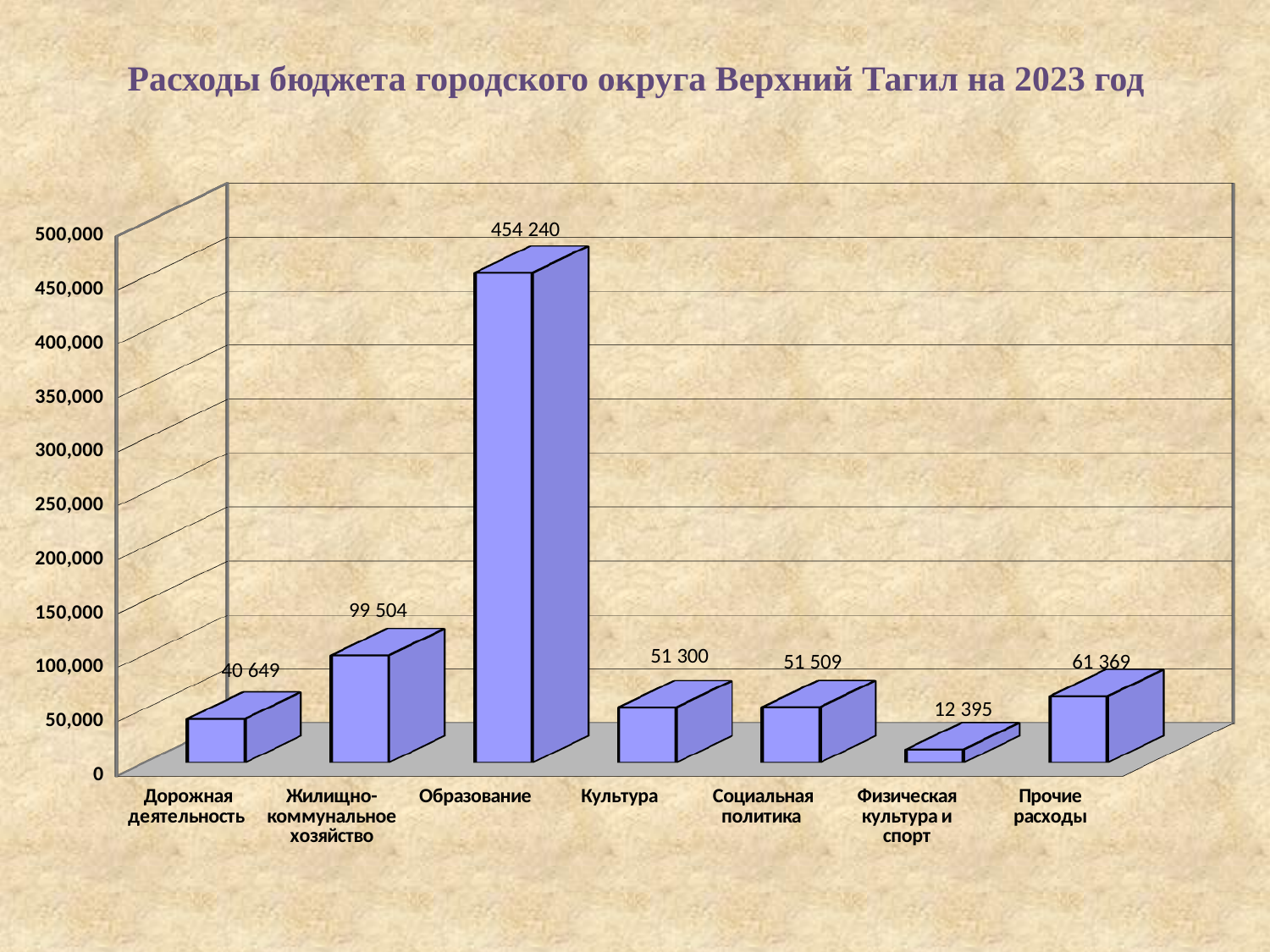
How many categories are shown on the chart? 7 What is the value for Физическая культура и спорт? 12 395 What is the value for Жилищно-коммунальное хозяйство? 99 504 What is the value for Образование? 454 240 Which category has the highest value? Образование Is the value for Дорожная деятельность greater or less than 50,000? less Which category has the lowest value? Физическая культура и спорт What is the value for Прочие расходы? 61 369 What is the difference between the values for Образование and Жилищно-коммунальное хозяйство? 354 736 Which is larger, the value for Жилищно-коммунальное хозяйство or the value for Прочие расходы? Жилищно-коммунальное хозяйство What kind of chart is shown on the slide? bar chart What is the difference between the values for Прочие расходы and Культура? 10 069